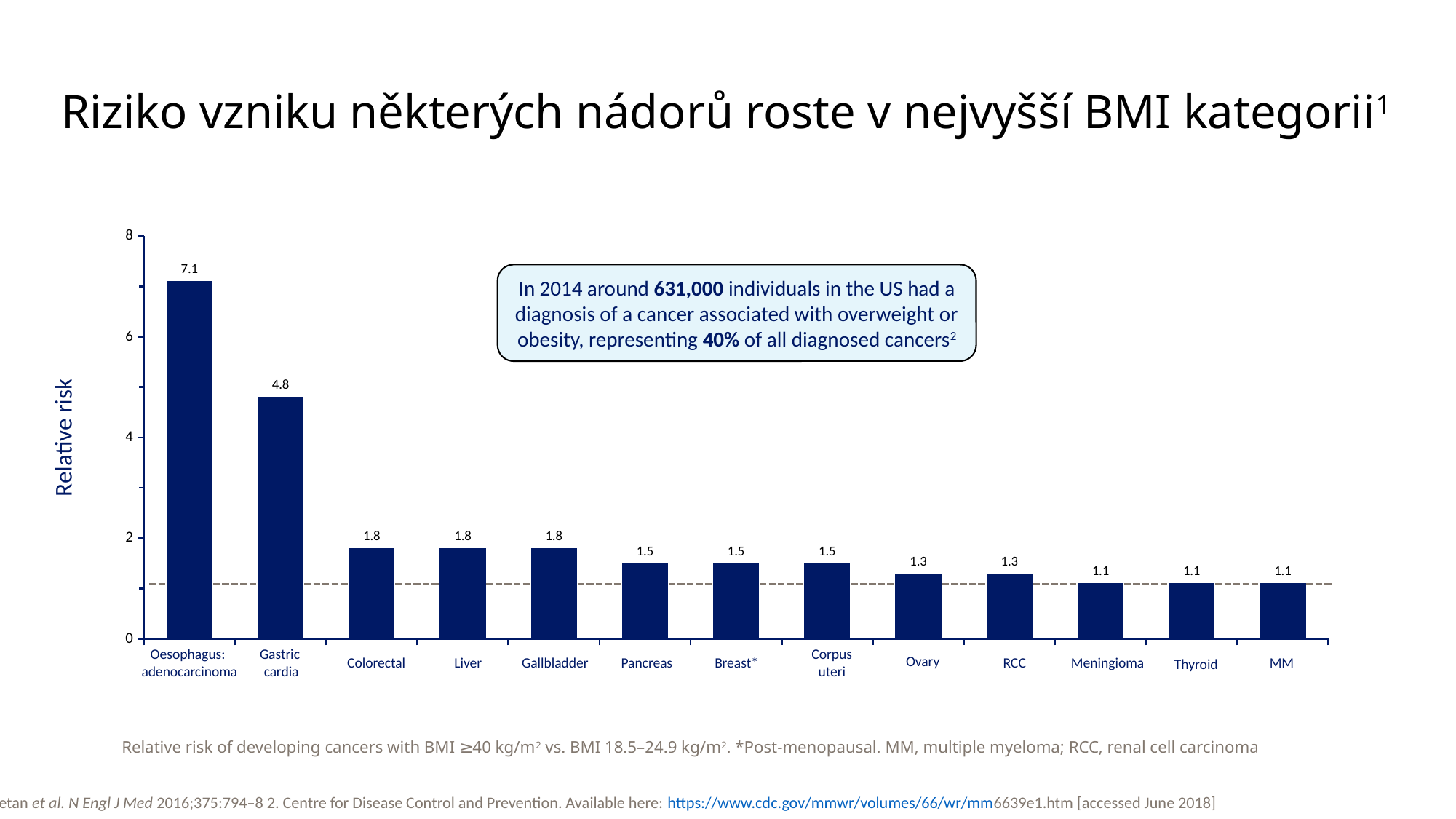
Do the relative risk values rise or fall from left to right along the x axis? Fall What is the relative risk for Pancreas? 1.5 How many cancer types are shown on the x axis? 13 Which has a higher relative risk, Liver or RCC? Liver What is the difference in relative risk between Oesophagus: adenocarcinoma and Gastric cardia? 2.3 What kind of chart is shown on the slide? Bar chart What is the label of the y axis? Relative risk What is the relative risk for Gastric cardia? 4.8 What is the difference in relative risk between Colorectal and Ovary? 0.5 Which cancer type has the highest relative risk? Oesophagus: adenocarcinoma What is the relative risk for Thyroid? 1.1 Is the relative risk for Gastric cardia greater or less than 4? greater